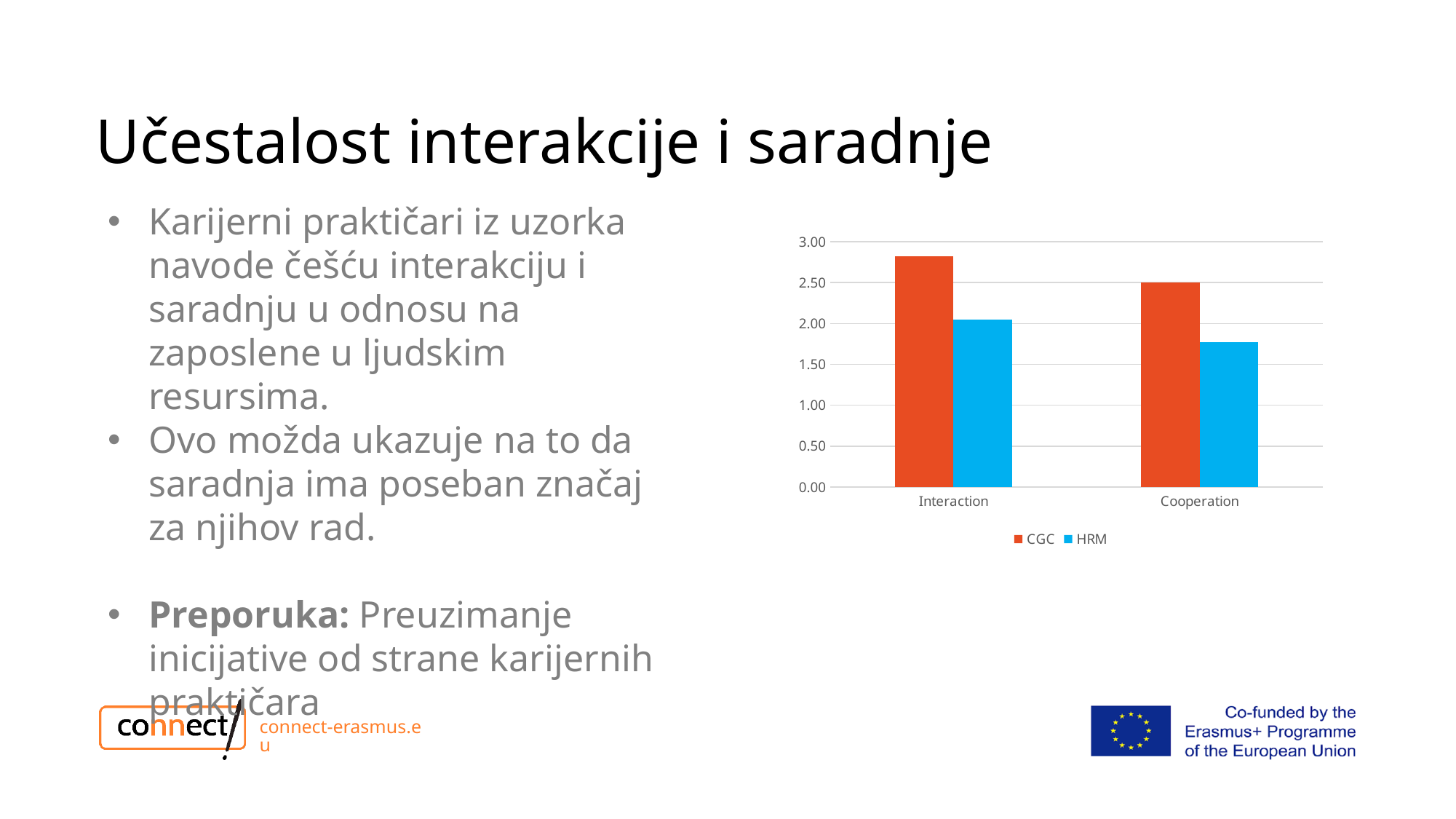
How many categories are shown on the x axis of the chart? 2 What colour are the CGC bars in the chart? orange-red Does the CGC series rise or fall from Interaction to Cooperation? fall What kind of chart is shown on the slide? bar chart How many series does the chart's legend list? 2 Which bar in the chart is the highest? CGC for Interaction Is the CGC value for Interaction greater or less than 2.50? greater Is the HRM value for Cooperation greater or less than 2.00? less Is the CGC value for Cooperation greater or less than 2.00? greater Which series has the higher value for Cooperation, CGC or HRM? CGC Which bar in the chart is the lowest? HRM for Cooperation Which series has the higher value for Interaction, CGC or HRM? CGC